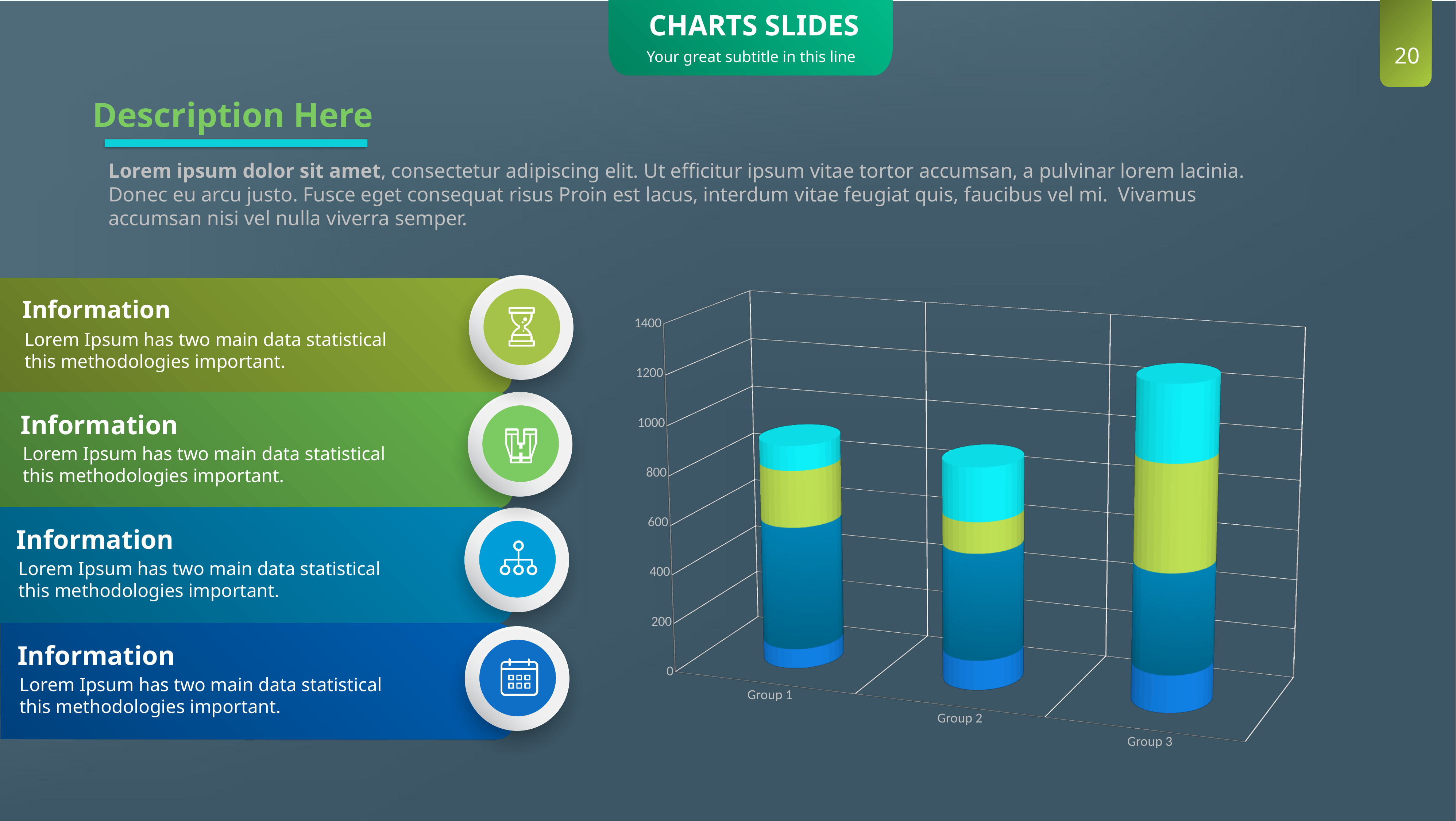
How many groups (categories) are shown on the x axis of the chart? 3 Is the total value for Group 2 greater or less than 1200? less Is the total value for Group 1 greater or less than 1200? less What is the label of the first category on the chart's x axis? Group 1 Is the total value for Group 1 greater or less than 600? greater Which is larger, the total for Group 3 or the total for Group 1? Group 3 Which group has the tallest stacked bar in the chart? Group 3 How many stacked segments make up each bar in the chart? 4 What kind of chart is shown on the slide? bar chart What is the highest value labelled on the chart's vertical axis? 1400